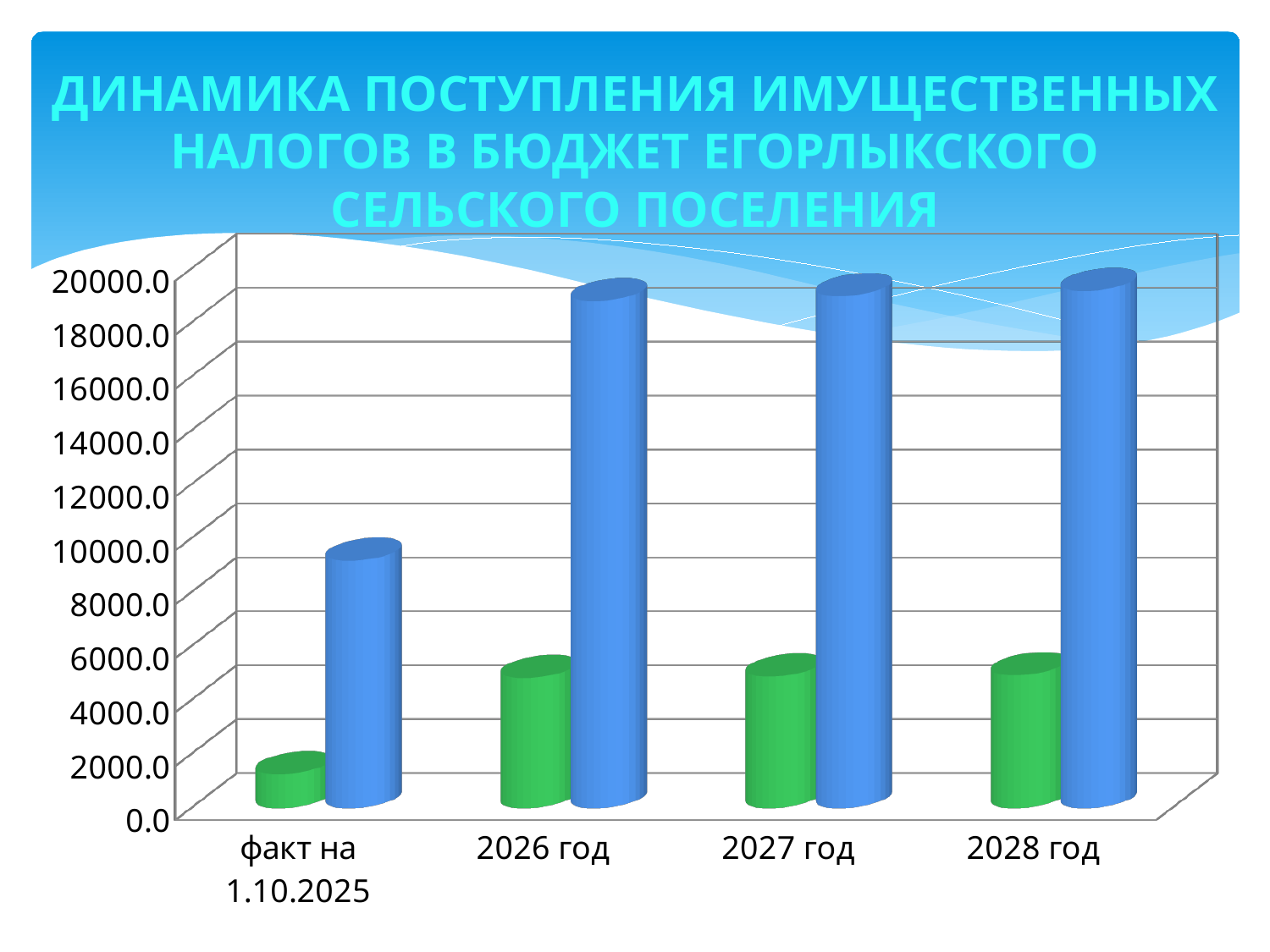
Is the value of the blue bar for 2026 год greater or less than 18000.0? greater What kind of chart is shown on the slide? bar chart Is the value of the green bar for 2027 год greater or less than 4000.0? greater Which is larger: the green bar for 2026 год or the green bar for факт на 1.10.2025? 2026 год What is the title of the chart on the slide? ДИНАМИКА ПОСТУПЛЕНИЯ ИМУЩЕСТВЕННЫХ НАЛОГОВ В БЮДЖЕТ ЕГОРЛЫКСКОГО СЕЛЬСКОГО ПОСЕЛЕНИЯ Does the blue series rise or fall from факт на 1.10.2025 to 2026 год? rise Is the value of the green bar for факт на 1.10.2025 greater or less than 2000.0? less Which is larger: the blue bar for факт на 1.10.2025 or the blue bar for 2026 год? 2026 год Which category has the lowest green bar? факт на 1.10.2025 How many categories are shown on the x axis of the chart? 4